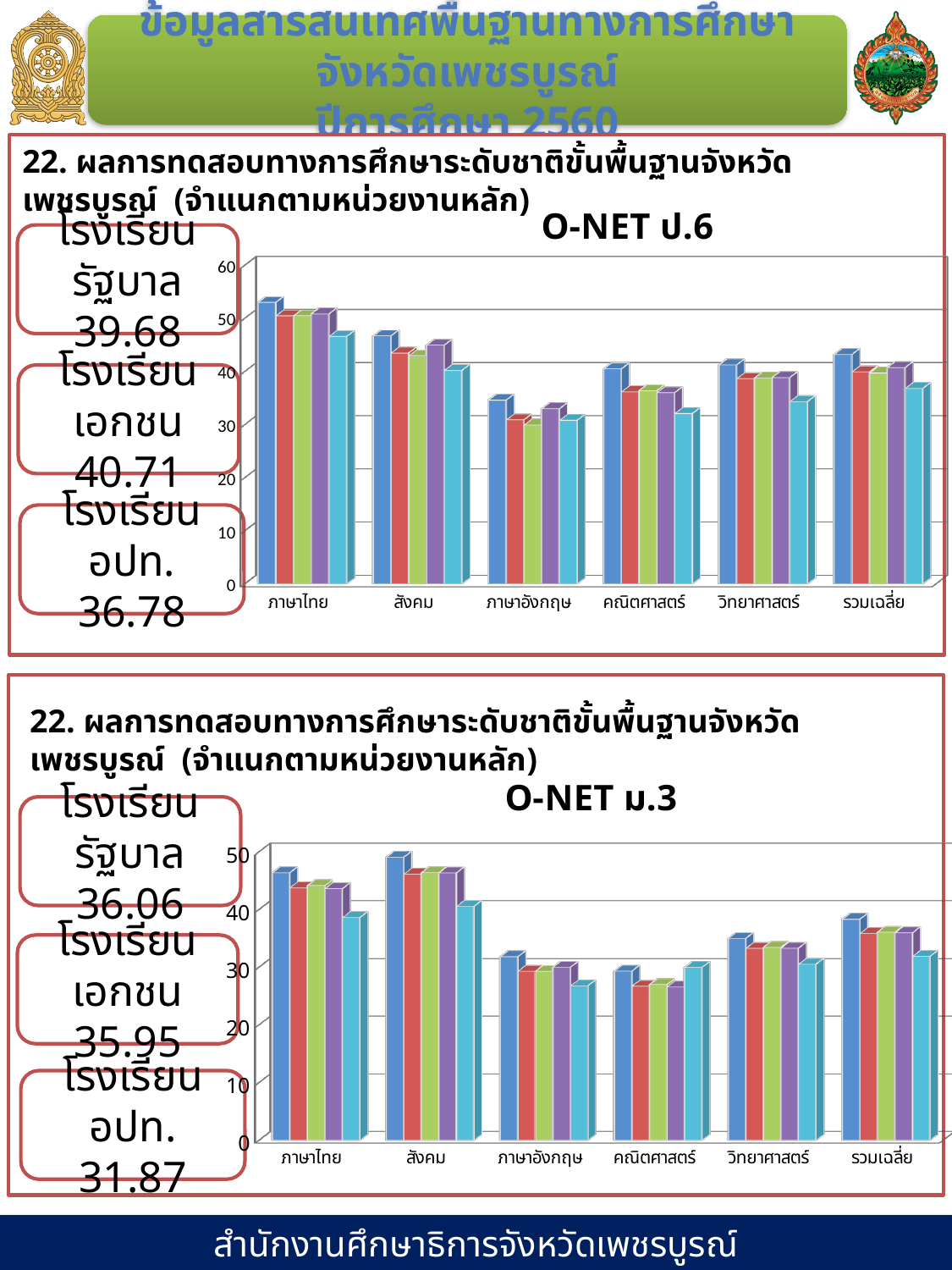
In the O-NET ม.3 chart, is the second (red) bar for คณิตศาสตร์ greater or less than 30? less In the O-NET ป.6 chart, is the first (blue) bar for ภาษาอังกฤษ greater or less than 40? less In the O-NET ม.3 chart, which category has the highest first (blue) bar? สังคม What is the title of the lower chart on the slide? O-NET ม.3 What kind of chart is the O-NET ป.6 chart? bar chart In the O-NET ป.6 chart, is the first (blue) bar larger for ภาษาไทย or for สังคม? ภาษาไทย In the O-NET ม.3 chart, is the first (blue) bar for ภาษาอังกฤษ greater or less than 40? less In the O-NET ป.6 chart, which category has the highest first (blue) bar? ภาษาไทย In the O-NET ป.6 chart, which category has the lowest first (blue) bar? ภาษาอังกฤษ How many bars are plotted for each category in the O-NET ม.3 chart? 5 How many categories are shown on the x axis of the O-NET ป.6 chart? 6